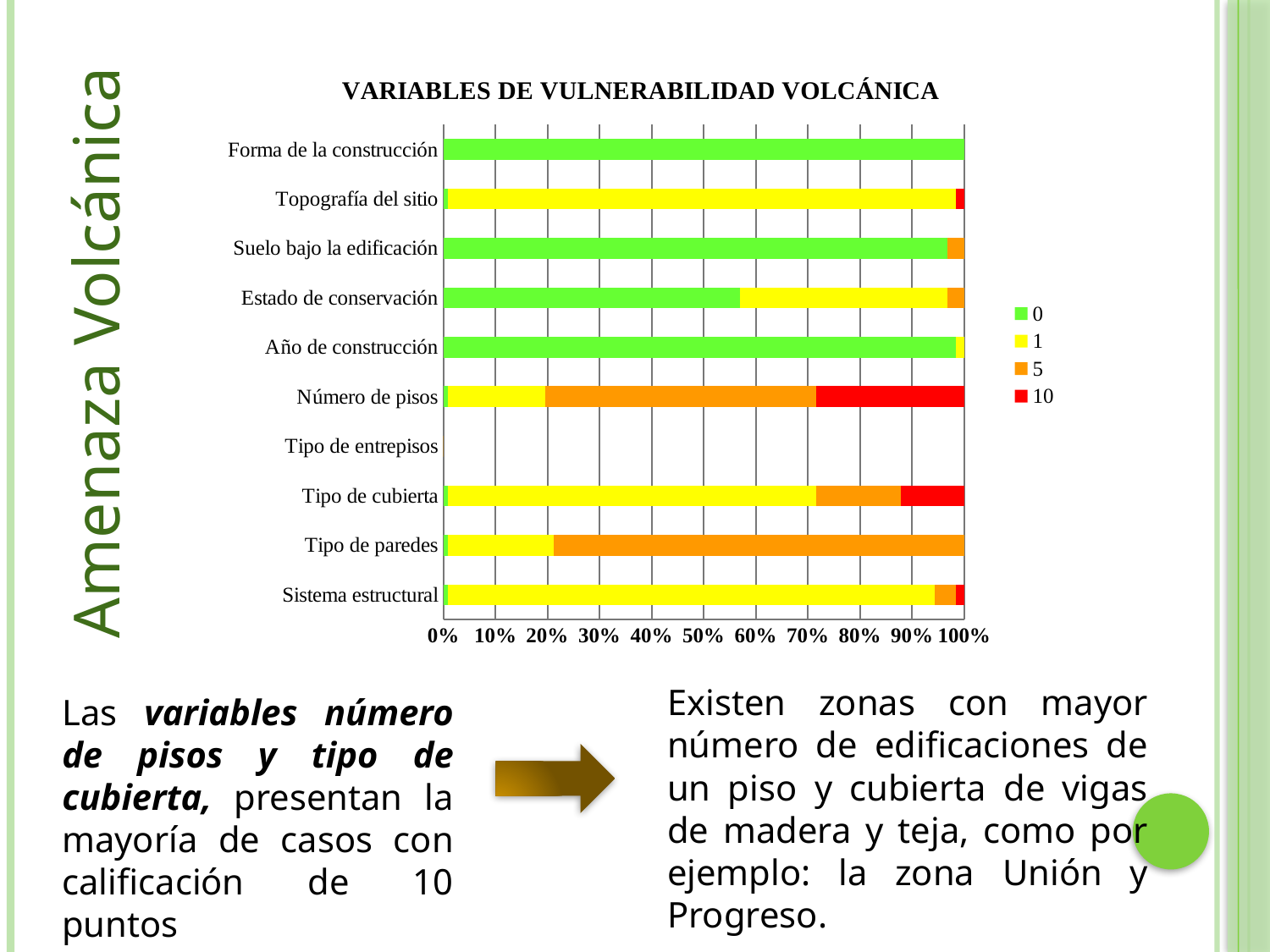
Which category has the largest segment for the series 10? Número de pisos Is the share of the series 0 for Estado de conservación greater or less than 50%? greater How many series does the chart legend list? 4 How many categories are listed on the vertical axis of the chart? 10 Is the share of the series 5 for Tipo de paredes greater or less than 70%? greater Which category has the largest segment for the series 5? Tipo de paredes What share of the bar for Forma de la construcción is taken by the series 0? 100% What is the title of the chart? VARIABLES DE VULNERABILIDAD VOLCÁNICA Which has a larger segment for the series 10: Número de pisos or Tipo de cubierta? Número de pisos Is the share of the series 10 for Número de pisos greater or less than 20%? greater What kind of chart is shown on the slide? Stacked bar chart What are the legend entries of the chart? 0, 1, 5, 10